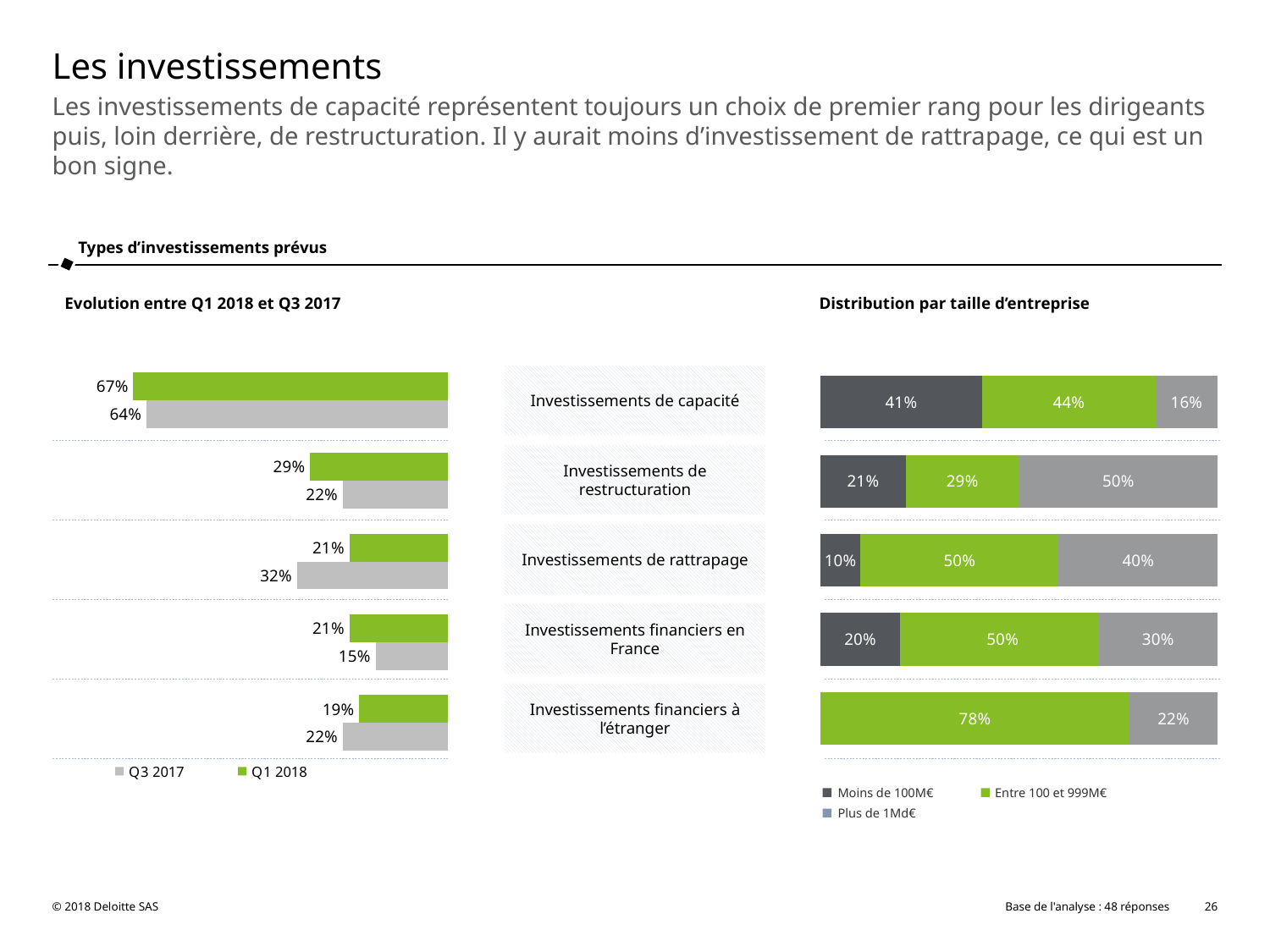
In the 'Evolution entre Q1 2018 et Q3 2017' chart, is the Q1 2018 value for Investissements de restructuration larger or smaller than its Q3 2017 value? larger How many investment types are shown in the 'Distribution par taille d'entreprise' chart? 5 In the 'Evolution entre Q1 2018 et Q3 2017' chart, what is the difference between the Q3 2017 and Q1 2018 values for Investissements de rattrapage? 11% In the 'Evolution entre Q1 2018 et Q3 2017' chart, which investment type has the lowest Q3 2017 value? Investissements financiers en France How many series does the legend of the 'Evolution entre Q1 2018 et Q3 2017' chart list? 2 In the 'Evolution entre Q1 2018 et Q3 2017' chart, what is the Q3 2017 value for Investissements de rattrapage? 32% What kind of chart is the 'Distribution par taille d'entreprise' chart? stacked bar chart How many series does the legend of the 'Distribution par taille d'entreprise' chart list? 3 In the 'Evolution entre Q1 2018 et Q3 2017' chart, which investment type has the highest Q1 2018 value? Investissements de capacité In the 'Evolution entre Q1 2018 et Q3 2017' chart, what is the Q1 2018 value for Investissements de capacité? 67% In the 'Distribution par taille d'entreprise' chart, what is the 'Moins de 100M€' share for Investissements de rattrapage? 10% In the 'Distribution par taille d'entreprise' chart, what is the 'Entre 100 et 999M€' share for Investissements financiers à l'étranger? 78%